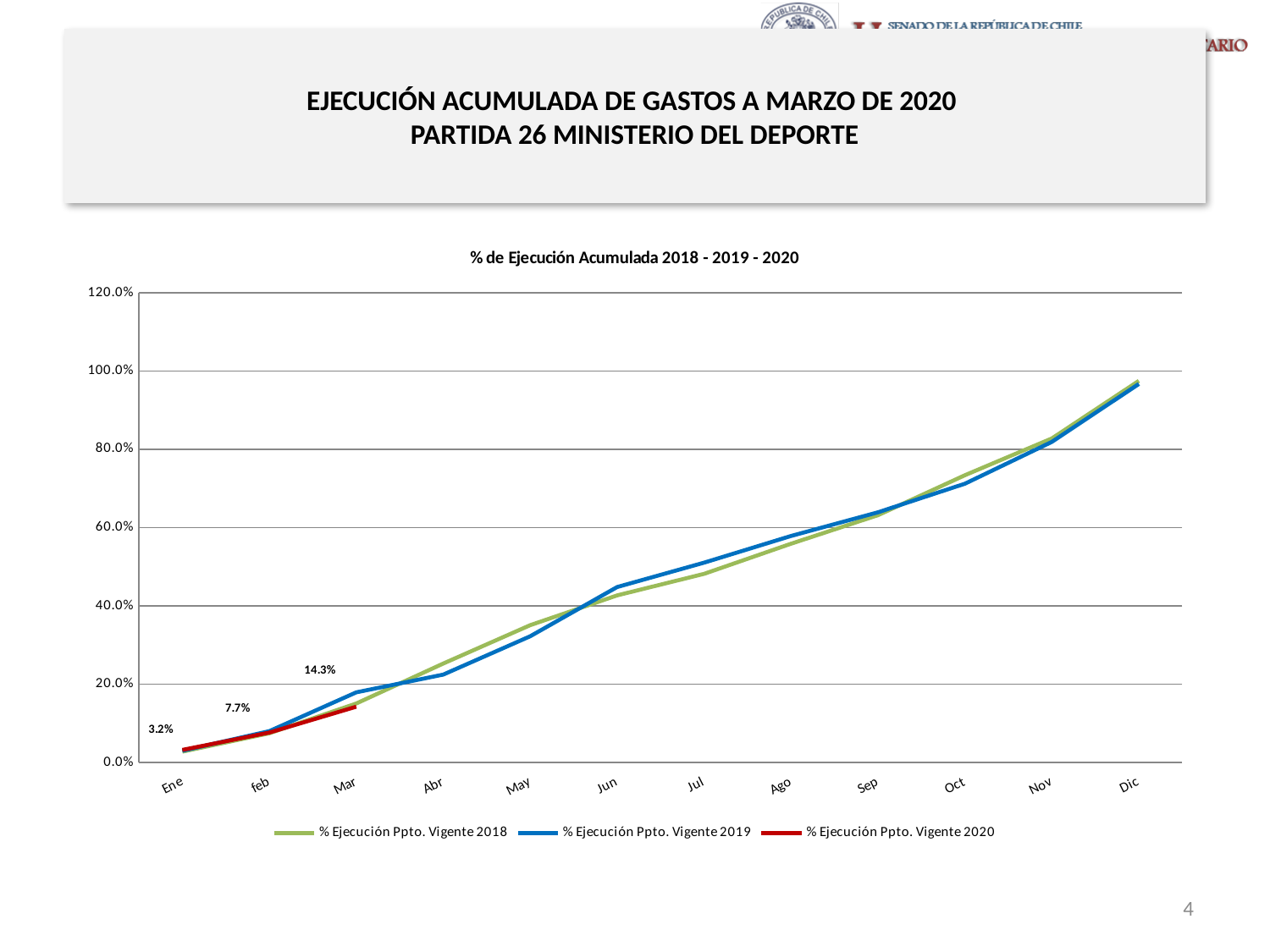
How many series does the legend list? 3 What is the difference between the 2020 values for Mar and feb? 6.6% Which month has the highest value for % Ejecución Ppto. Vigente 2020? Mar What is the value of % Ejecución Ppto. Vigente 2020 for feb? 7.7% Is the value for % Ejecución Ppto. Vigente 2018 in Jun greater or less than 60%? less What is the value of % Ejecución Ppto. Vigente 2020 for Ene? 3.2% What is the value of % Ejecución Ppto. Vigente 2020 for Mar? 14.3% What is the title of the chart? % de Ejecución Acumulada 2018 - 2019 - 2020 Do the values for % Ejecución Ppto. Vigente 2019 rise or fall from Ene to Dic? Rise What type of chart is shown on the slide? Line chart Is the value for % Ejecución Ppto. Vigente 2019 in Dic greater or less than 80%? greater How many months are shown on the x axis? 12